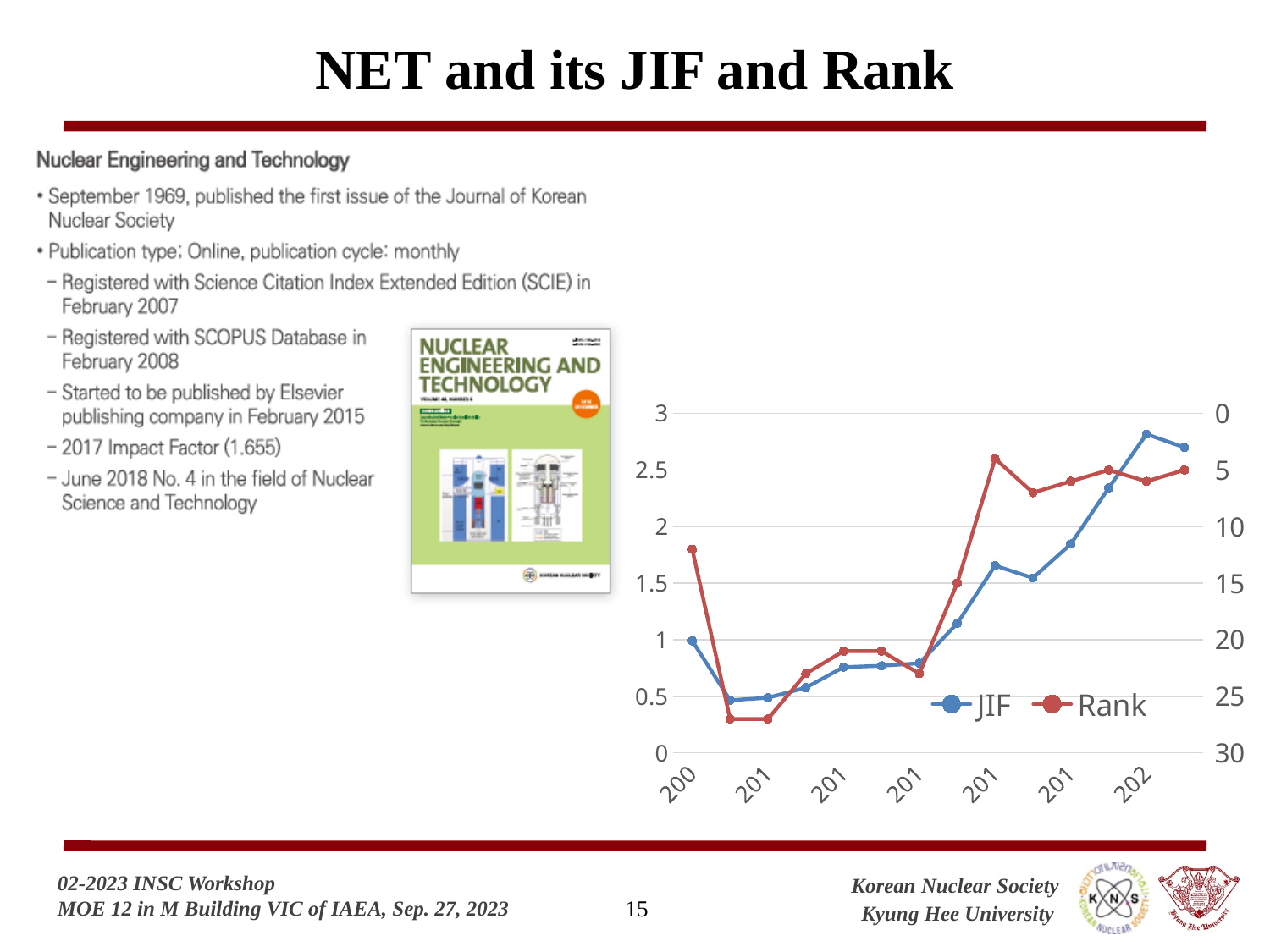
What is the largest tick value shown on the right vertical axis? 30 Is the lowest value on the JIF line greater or less than 1 on the left axis? less What is the highest tick value shown on the left vertical axis? 3 Which colour is used for the JIF line in the chart? blue How many series does the chart legend list? 2 Is the highest value on the JIF line greater or less than 2.5 on the left axis? greater How many data points does the JIF line have? 14 Overall, does the JIF line rise or fall from left to right along the x axis? rise What kind of chart is shown on the slide? line chart